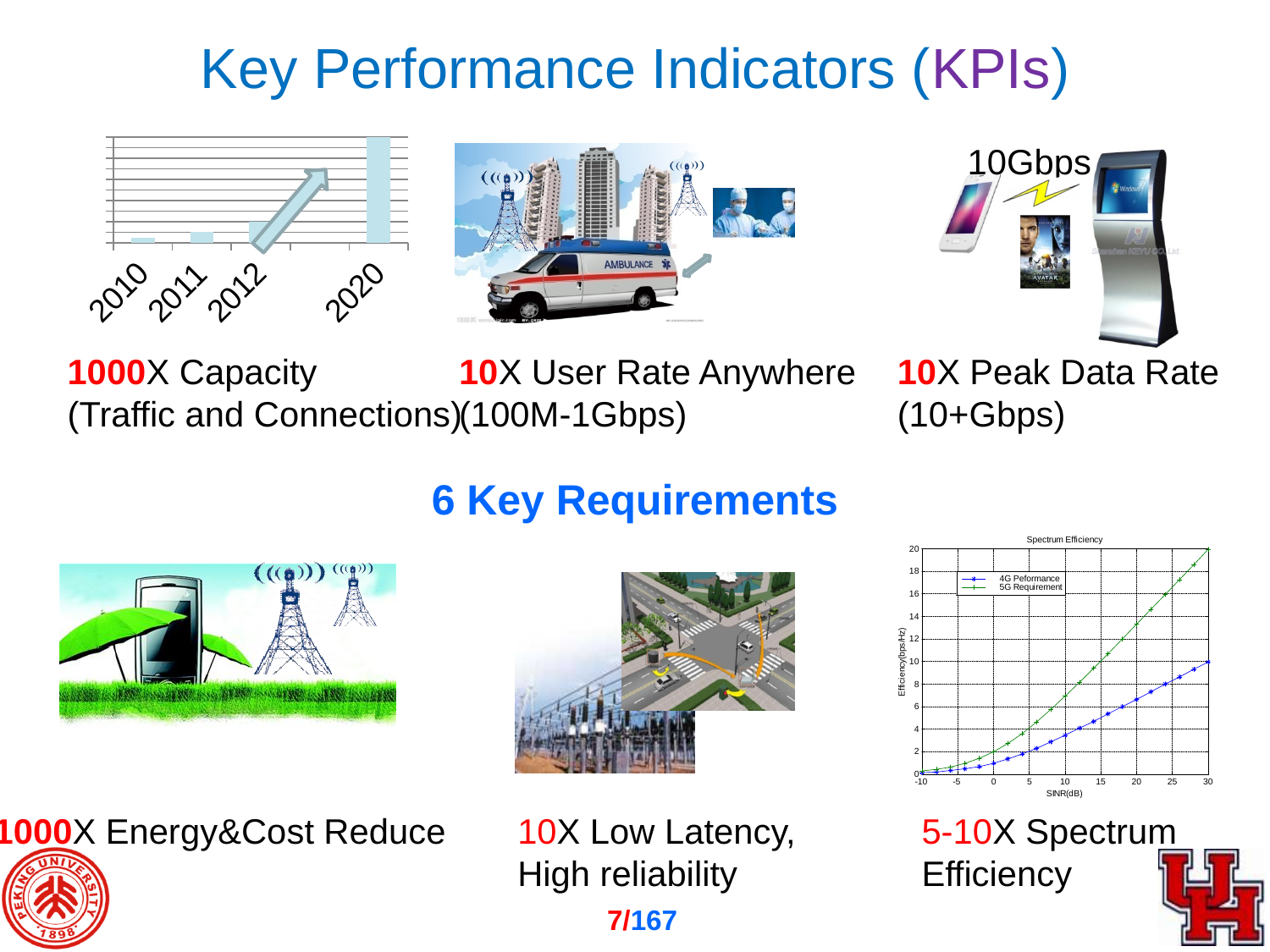
In the 'Spectrum Efficiency' chart, is the 5G Requirement value at SINR 30 dB greater or less than 15? greater In the bar chart at the top left of the slide, which category has the tallest bar? 2020 In the bar chart at the top left of the slide, how many categories are shown on the x axis? 4 In the 'Spectrum Efficiency' chart, at SINR 30 dB, which series has the higher efficiency, 4G Peformance or 5G Requirement? 5G Requirement How many series does the legend of the 'Spectrum Efficiency' chart list? 2 In the bar chart at the top left of the slide, do the bars rise or fall from 2010 to 2020? rise What is the title of the line chart at the bottom right of the slide? Spectrum Efficiency What kind of chart is the 'Spectrum Efficiency' chart at the bottom right of the slide? line chart In the bar chart at the top left of the slide, which category has the shortest bar? 2010 What kind of chart is shown at the top left of the slide, above the '1000X Capacity' label? bar chart What are the two series named in the legend of the 'Spectrum Efficiency' chart? 4G Peformance and 5G Requirement In the 'Spectrum Efficiency' chart, do the efficiency values rise or fall as SINR increases? rise